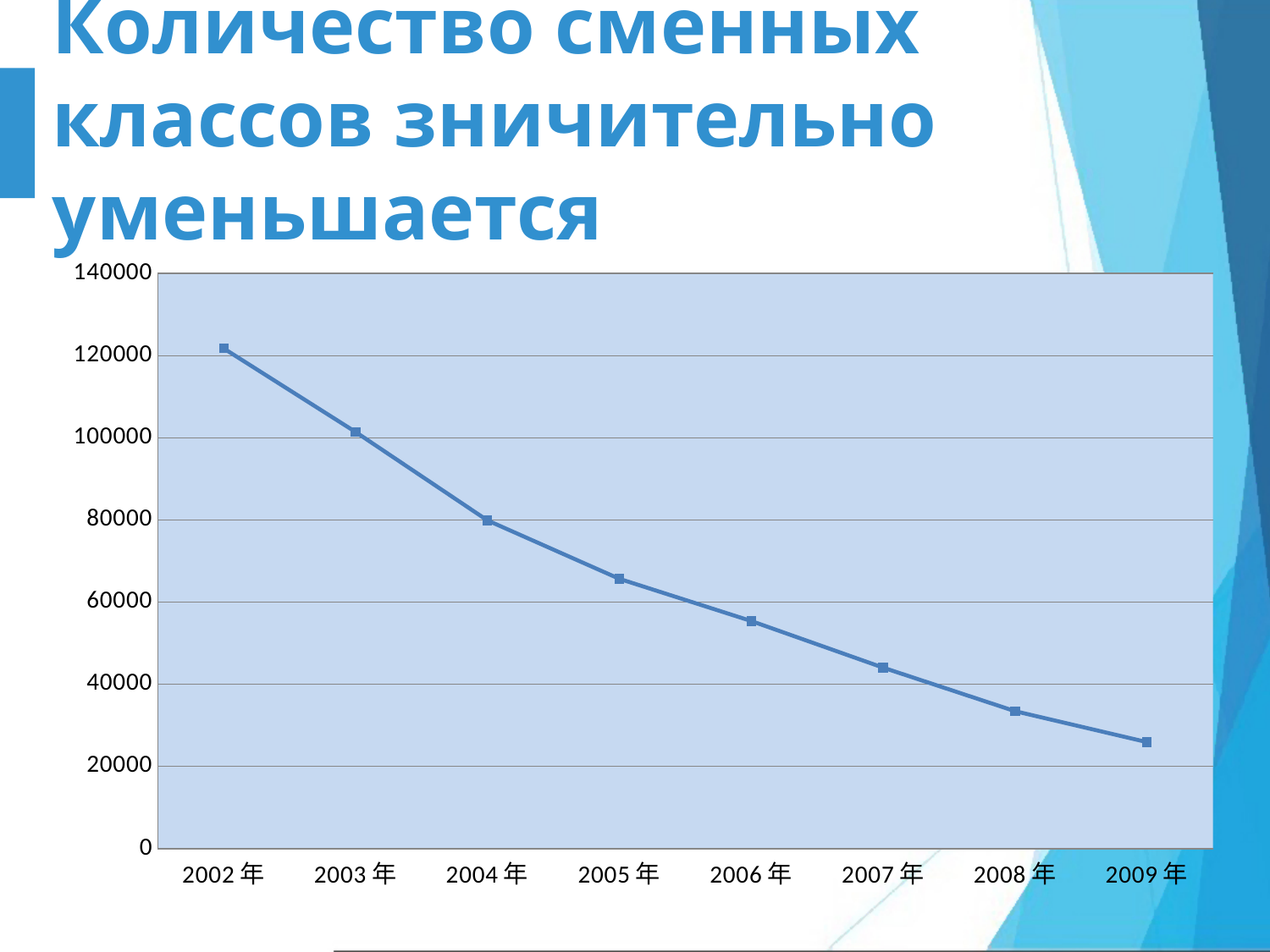
What kind of chart is shown on the slide? line chart Is the value for 2007 年 greater or less than 40000? greater Which year has the highest value? 2002 年 How many years are plotted on the x axis? 8 Which year has the lowest value? 2009 年 Is the value for 2008 年 greater or less than 40000? less Is the value for 2002 年 greater or less than 100000? greater Which is larger, the value for 2003 年 or the value for 2008 年? 2003 年 Do the values rise or fall from 2002 年 to 2009 年? fall What is the highest value shown on the y axis? 140000